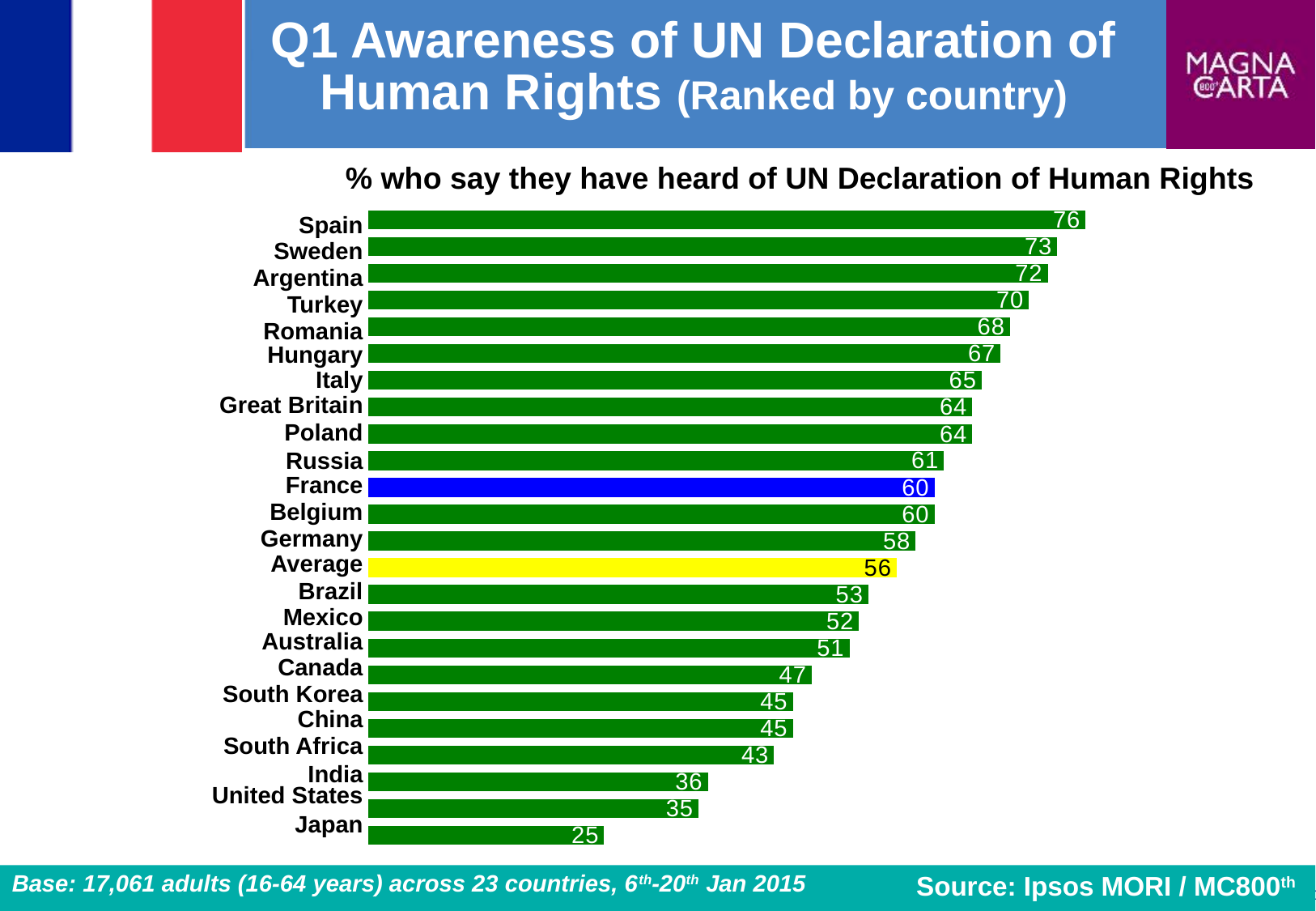
Which country has the highest value? Spain Which country has the lowest value? Japan How many bars are plotted on the chart, including the Average? 24 What is the value for Japan? 25 What kind of chart is shown on the slide? Bar chart Which has a larger value, Canada or Brazil? Brazil What is the value for Spain? 76 What is the difference between the values for Germany and the Average? 2 What is the difference between the values for Spain and Japan? 51 What is the value shown for the Average bar? 56 Which bar is coloured yellow? Average What is the value for France? 60